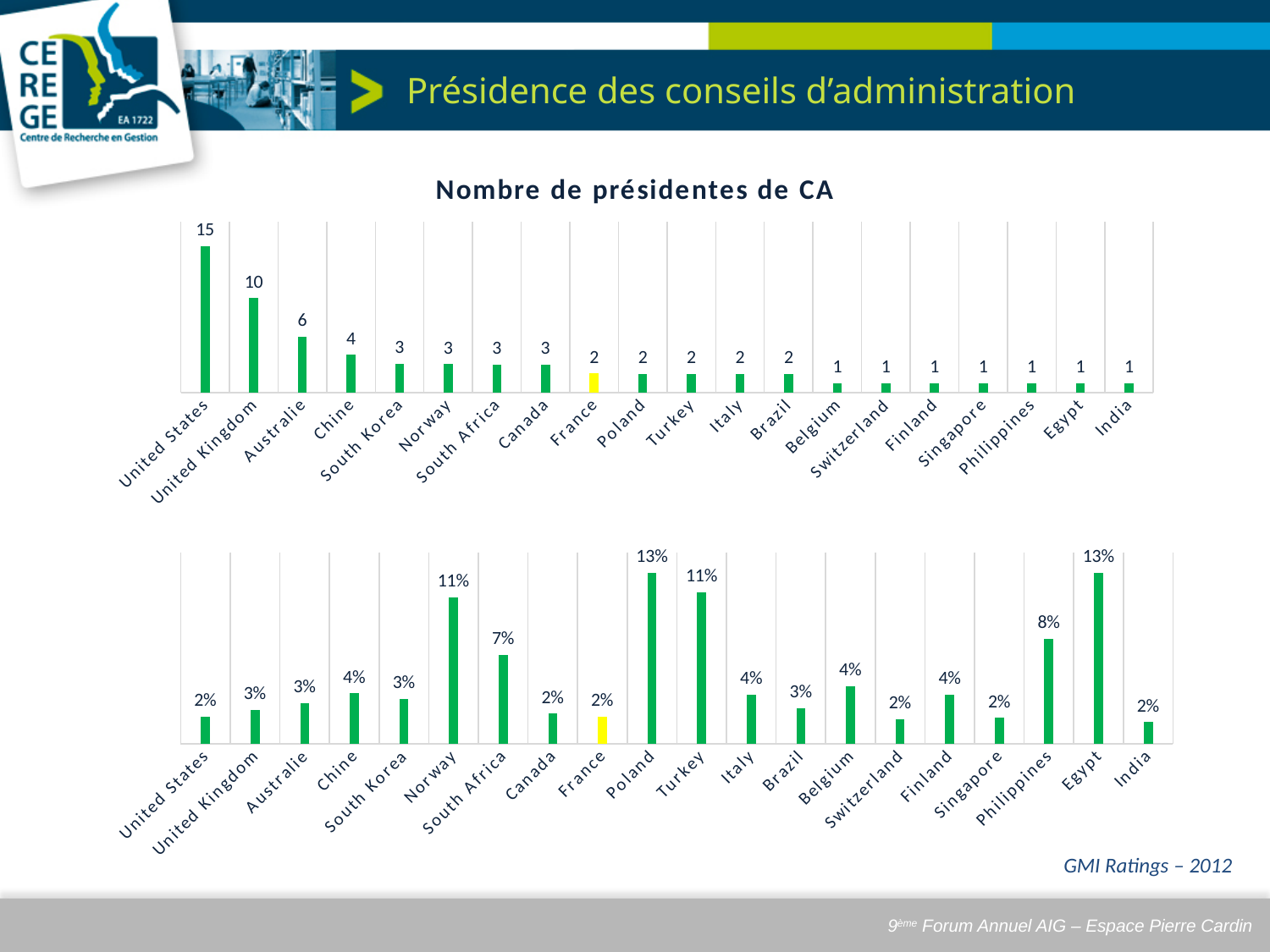
In the bottom chart, what is the difference between Poland and Turkey? 2% In the top chart 'Nombre de présidentes de CA', which country's bar is coloured yellow instead of green? France In the bottom chart, which is larger, the value for South Africa or the value for Canada? South Africa In the top chart 'Nombre de présidentes de CA', what is the value for France? 2 In the top chart 'Nombre de présidentes de CA', which country has the highest value? United States In the top chart 'Nombre de présidentes de CA', what is the value for United States? 15 In the top chart 'Nombre de présidentes de CA', what is the difference between United States and United Kingdom? 5 In the bottom chart, which country has the lowest value among Norway, Poland and Egypt? Norway What kind of chart is the top chart 'Nombre de présidentes de CA'? bar chart In the bottom chart, what is the value for Norway? 11% In the bottom chart, what is the value for Philippines? 8% In the top chart 'Nombre de présidentes de CA', how many countries are shown? 20